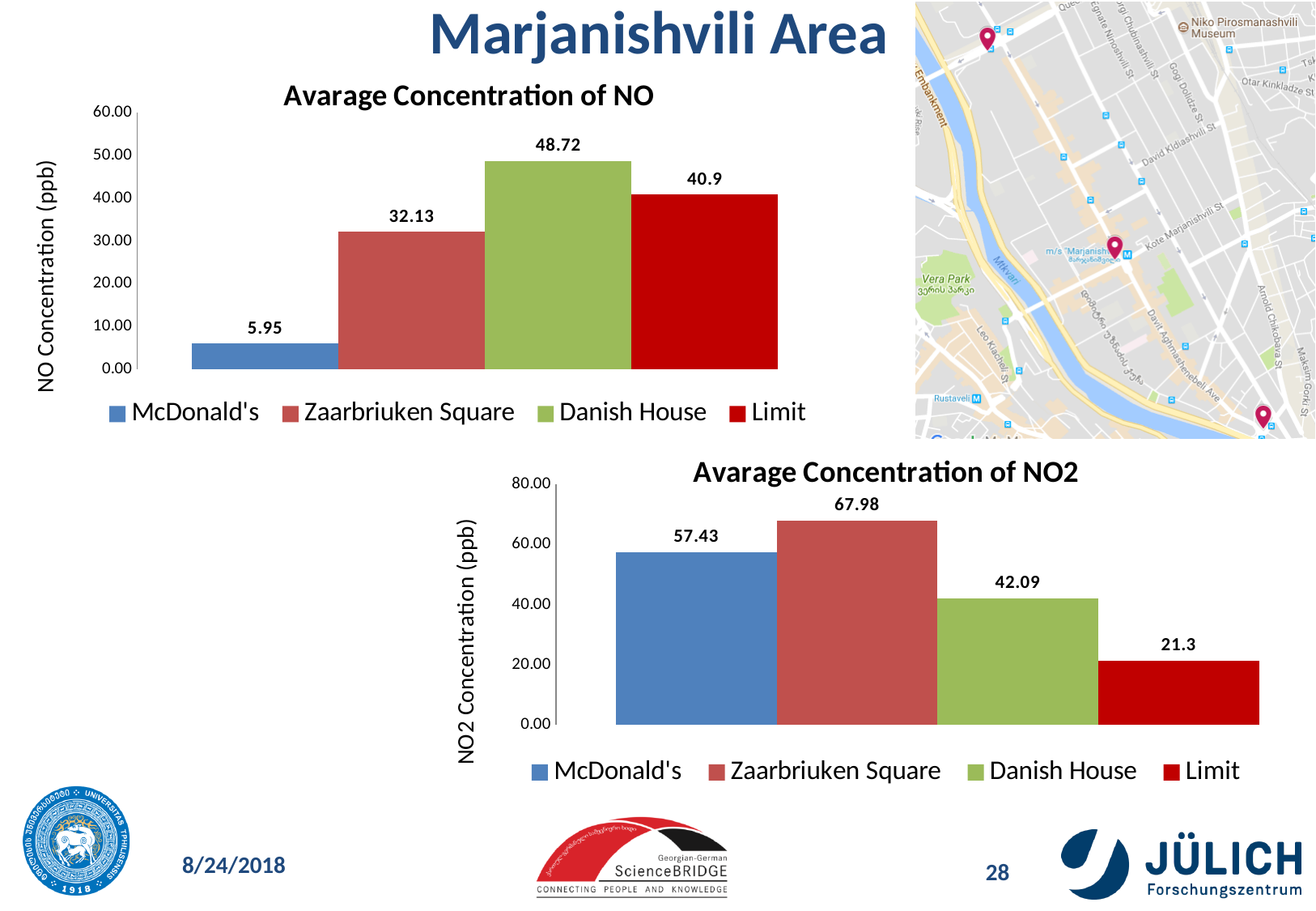
In the 'Avarage Concentration of NO2' chart, what is the Limit value? 21.3 In the 'Avarage Concentration of NO' chart, which series has the highest value? Danish House In the 'Avarage Concentration of NO2' chart, what is the value for Zaarbriuken Square? 67.98 In the 'Avarage Concentration of NO' chart, what is the value for Danish House? 48.72 How many series does the legend of the 'Avarage Concentration of NO' chart list? 4 In the 'Avarage Concentration of NO2' chart, which is larger, the value for McDonald's or the value for Danish House? McDonald's In the 'Avarage Concentration of NO' chart, what is the value for McDonald's? 5.95 What kind of chart is the 'Avarage Concentration of NO2' chart? Bar chart In the 'Avarage Concentration of NO2' chart, what is the difference between the McDonald's value and the Limit value? 36.13 In the 'Avarage Concentration of NO' chart, which series has the lowest value? McDonald's In the 'Avarage Concentration of NO2' chart, which series has the highest value? Zaarbriuken Square In the 'Avarage Concentration of NO' chart, what is the difference between the Danish House value and the Limit value? 7.82